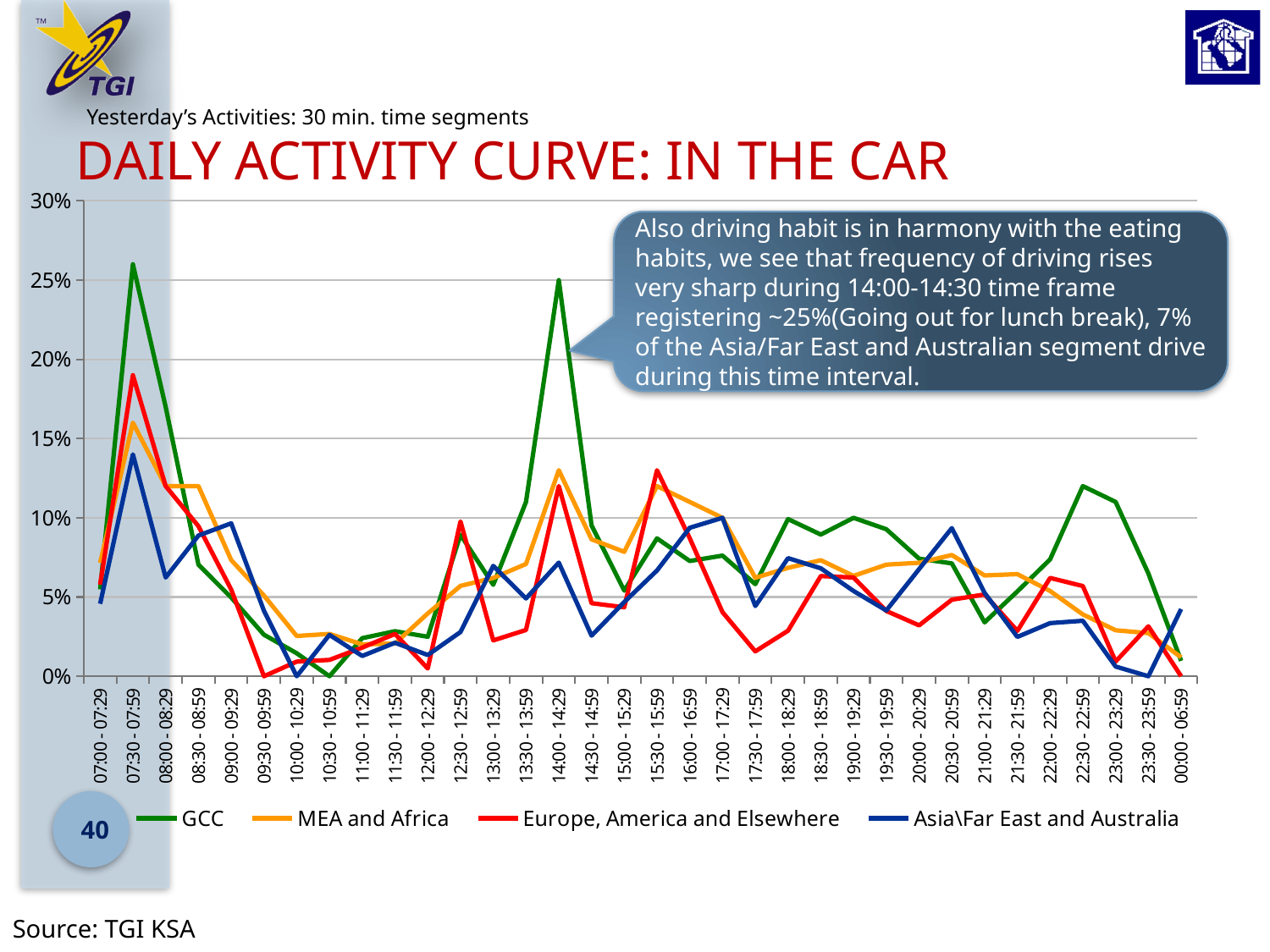
At 14:00 - 14:29, which is larger: the GCC value or the MEA and Africa value? GCC Is the GCC value for 14:00 - 14:29 greater or less than 20%? greater Which series has the lowest value at 07:30 - 07:59? Asia\Far East and Australia Does the GCC line rise or fall from 07:30 - 07:59 to 09:30 - 09:59? fall What colour is the GCC line in the legend? Green How many time segments are plotted along the x axis? 34 Is the GCC value for 07:30 - 07:59 greater or less than 20%? greater Which series has the highest value at 14:00 - 14:29? GCC Is the Europe, America and Elsewhere value for 09:30 - 09:59 greater or less than 5%? less What kind of chart is shown on the slide? Line chart How many series does the legend list? 4